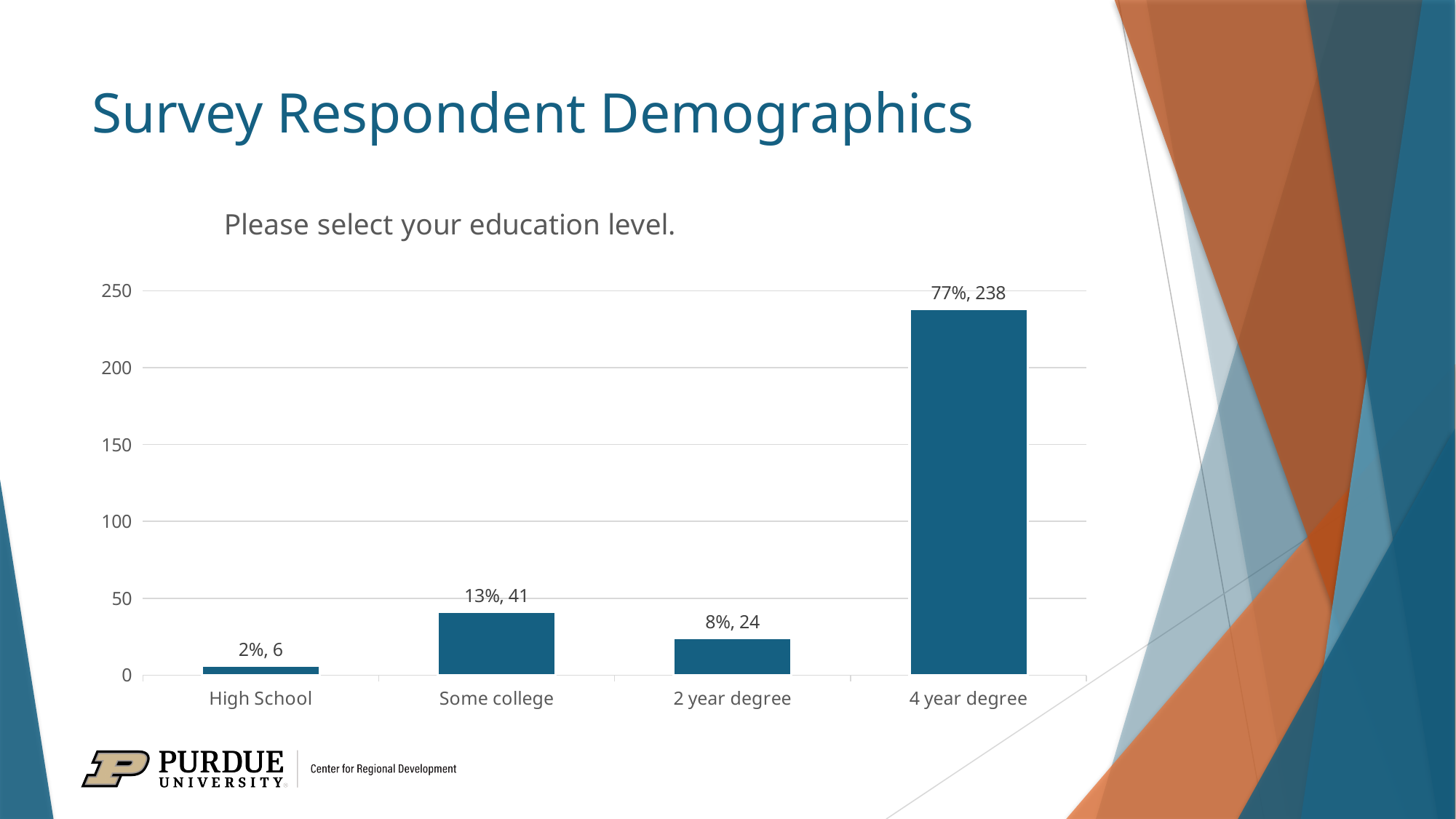
Which has more respondents, "Some college" or "2 year degree"? Some college Is the value for "4 year degree" greater or less than 200? greater How many respondents selected "High School"? 6 Which education level has the highest number of respondents? 4 year degree What percentage of respondents selected "Some college"? 13% How many respondents selected "4 year degree"? 238 Which education level has the lowest number of respondents? High School What is the title of the chart? Please select your education level. How many education level categories are shown on the chart? 4 What kind of chart is shown on the slide? bar chart What percentage of respondents selected "2 year degree"? 8% What is the difference in respondent count between "Some college" and "2 year degree"? 17